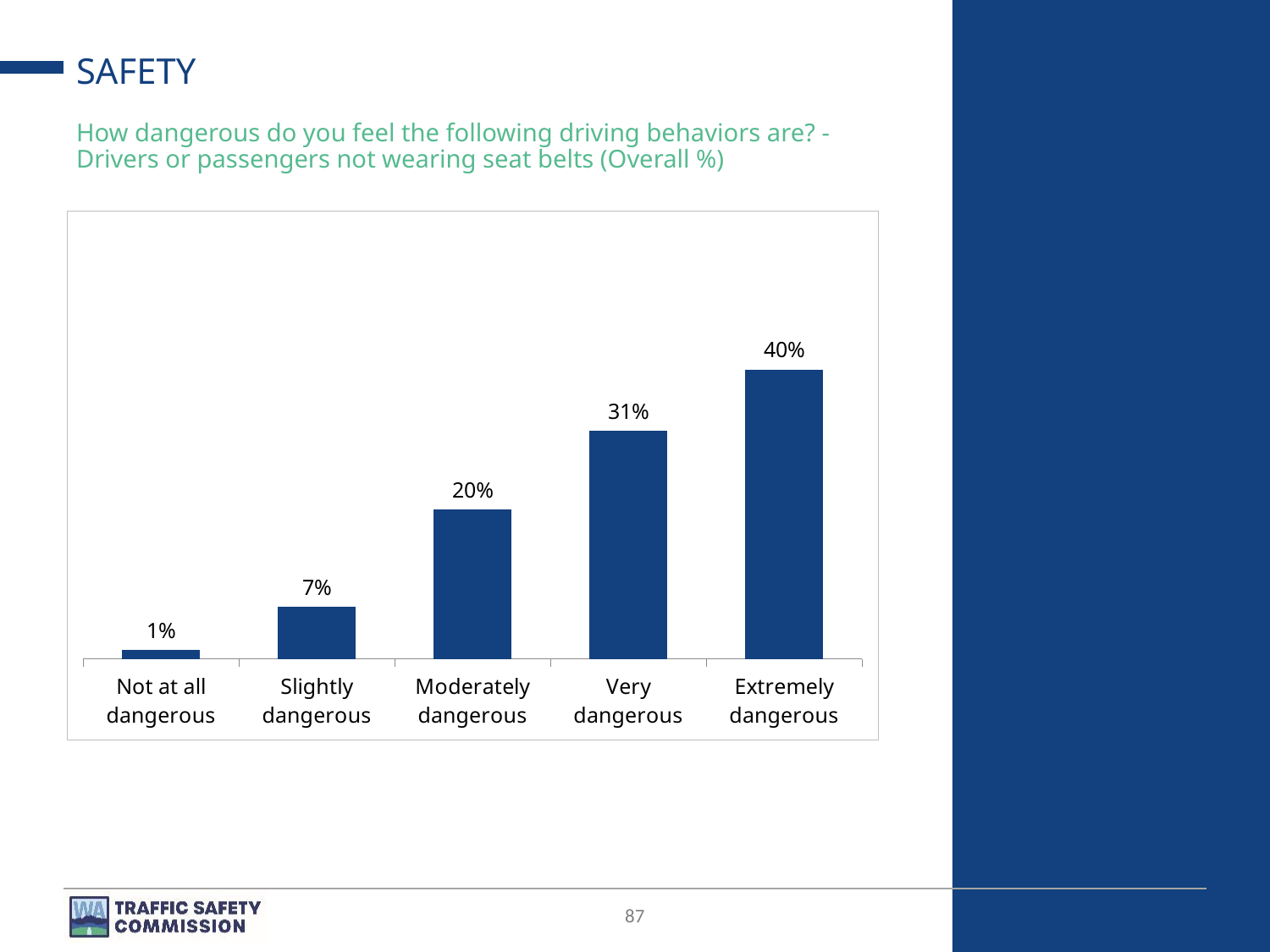
What is the difference between the values for "Moderately dangerous" and "Slightly dangerous"? 13% Which category has the lowest value? Not at all dangerous What kind of chart is shown on the slide? Bar chart Which is larger, the value for "Very dangerous" or the value for "Moderately dangerous"? Very dangerous What is the value for "Moderately dangerous"? 20% What percentage of respondents rated not wearing seat belts as "Extremely dangerous"? 40% Which driving behavior does the chart's question refer to? Drivers or passengers not wearing seat belts How many categories are shown on the chart? 5 Do the values rise or fall moving from left to right along the x axis? Rise Which category has the highest value? Extremely dangerous What is the value for "Slightly dangerous"? 7% What is the difference between the values for "Extremely dangerous" and "Very dangerous"? 9%